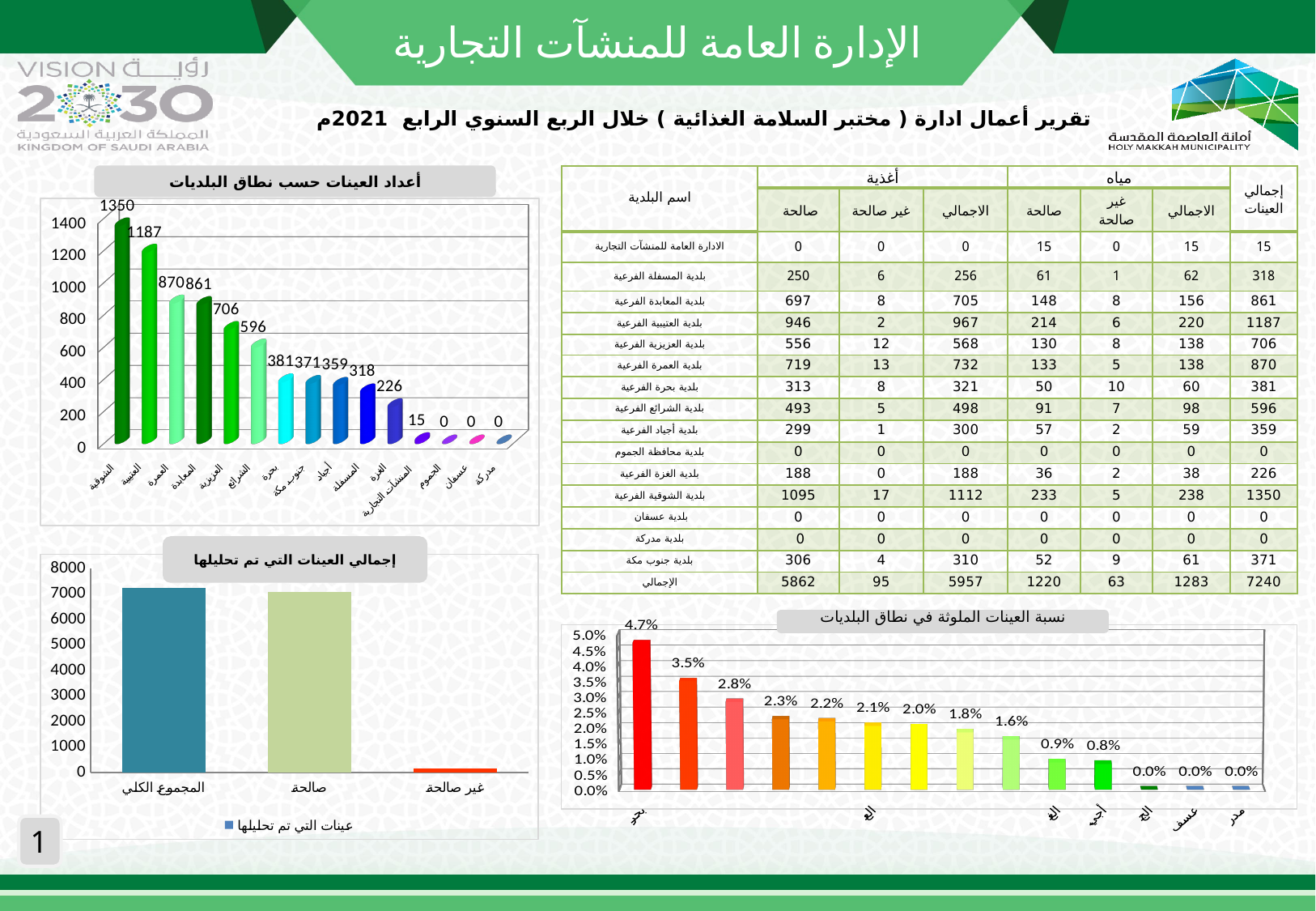
In the chart titled نسبة العينات الملوثة في نطاق البلديات, do the values rise or fall from left to right? fall What is the legend entry shown in the chart titled إجمالي العينات التي تم تحليلها? عينات التي تم تحليلها In the chart titled أعداد العينات حسب نطاق البلديات, what is the value for الغزة? 226 In the chart titled أعداد العينات حسب نطاق البلديات, which category has the highest value? الشوقية What kind of chart is the one titled أعداد العينات حسب نطاق البلديات? bar chart In the chart titled أعداد العينات حسب نطاق البلديات, what is the value for العتيبية? 1187 In the chart titled إجمالي العينات التي تم تحليلها, which is larger, صالحة or غير صالحة? صالحة In the chart titled إجمالي العينات التي تم تحليلها, is the value for المجموع الكلي greater or less than 7000? greater In the chart titled نسبة العينات الملوثة في نطاق البلديات, what is the highest value shown? 4.7% How many categories are shown in the chart titled أعداد العينات حسب نطاق البلديات? 15 In the chart titled أعداد العينات حسب نطاق البلديات, what is the difference between the values for الشوقية and العتيبية? 163 In the chart titled أعداد العينات حسب نطاق البلديات, what is the value for الشوقية? 1350